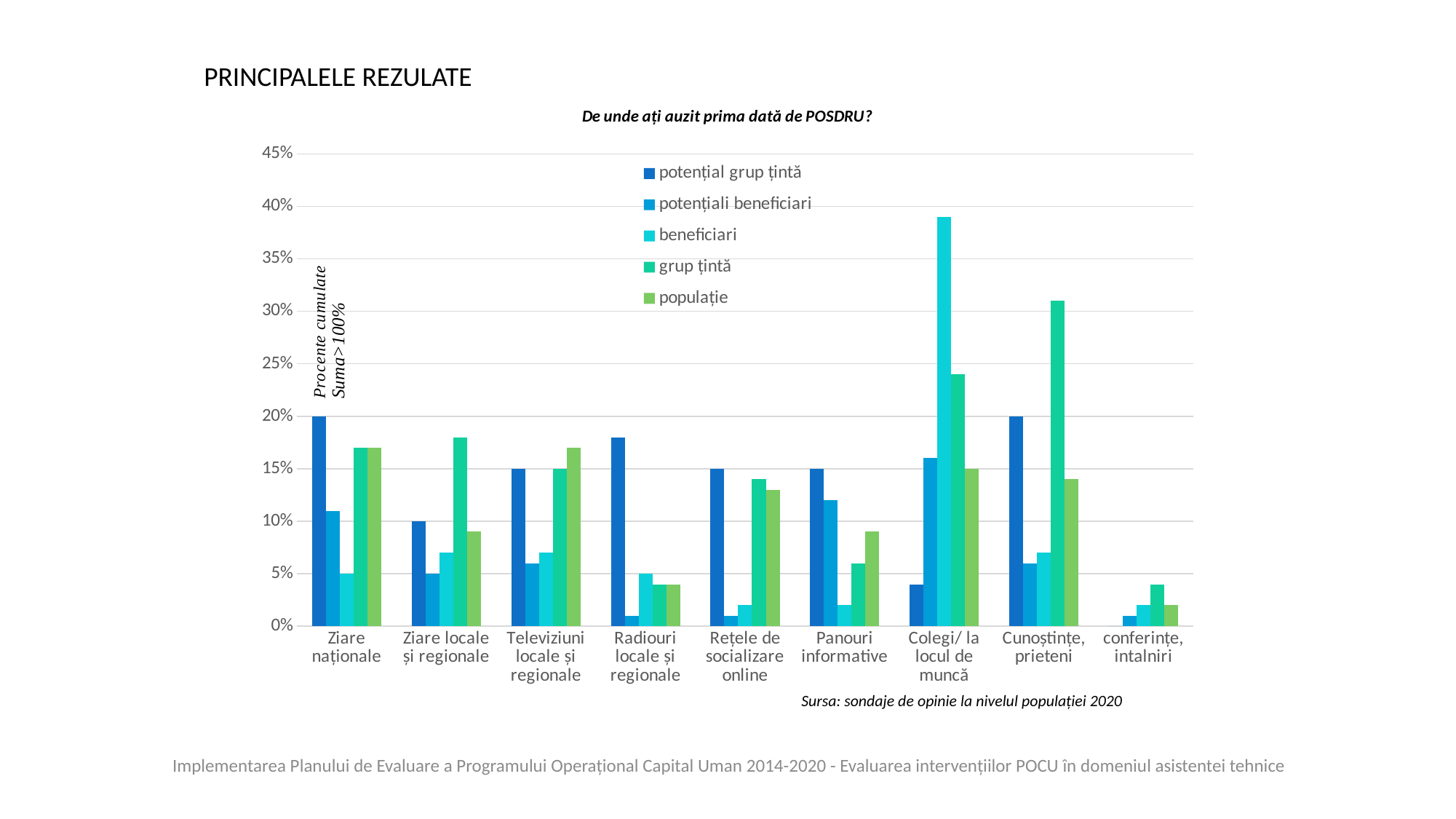
What is the title of the chart? De unde ați auzit prima dată de POSDRU? Is the 'populație' value for 'Radiouri locale și regionale' greater or less than 5%? less What is the value for 'potențial grup țintă' in the 'Cunoștințe, prieteni' category? 20% What kind of chart is shown on the slide? bar chart In the 'Colegi/ la locul de muncă' category, which is larger: the 'beneficiari' value or the 'grup țintă' value? beneficiari Which category has the highest 'grup țintă' value? Cunoștințe, prieteni How many series does the legend list? 5 What is the value for 'potențial grup țintă' in the 'Ziare naționale' category? 20% Is the 'grup țintă' value for 'Cunoștințe, prieteni' greater or less than 25%? greater Which category has the highest 'beneficiari' value? Colegi/ la locul de muncă Is the 'beneficiari' value for 'Colegi/ la locul de muncă' greater or less than 35%? greater How many categories are shown on the x axis? 9